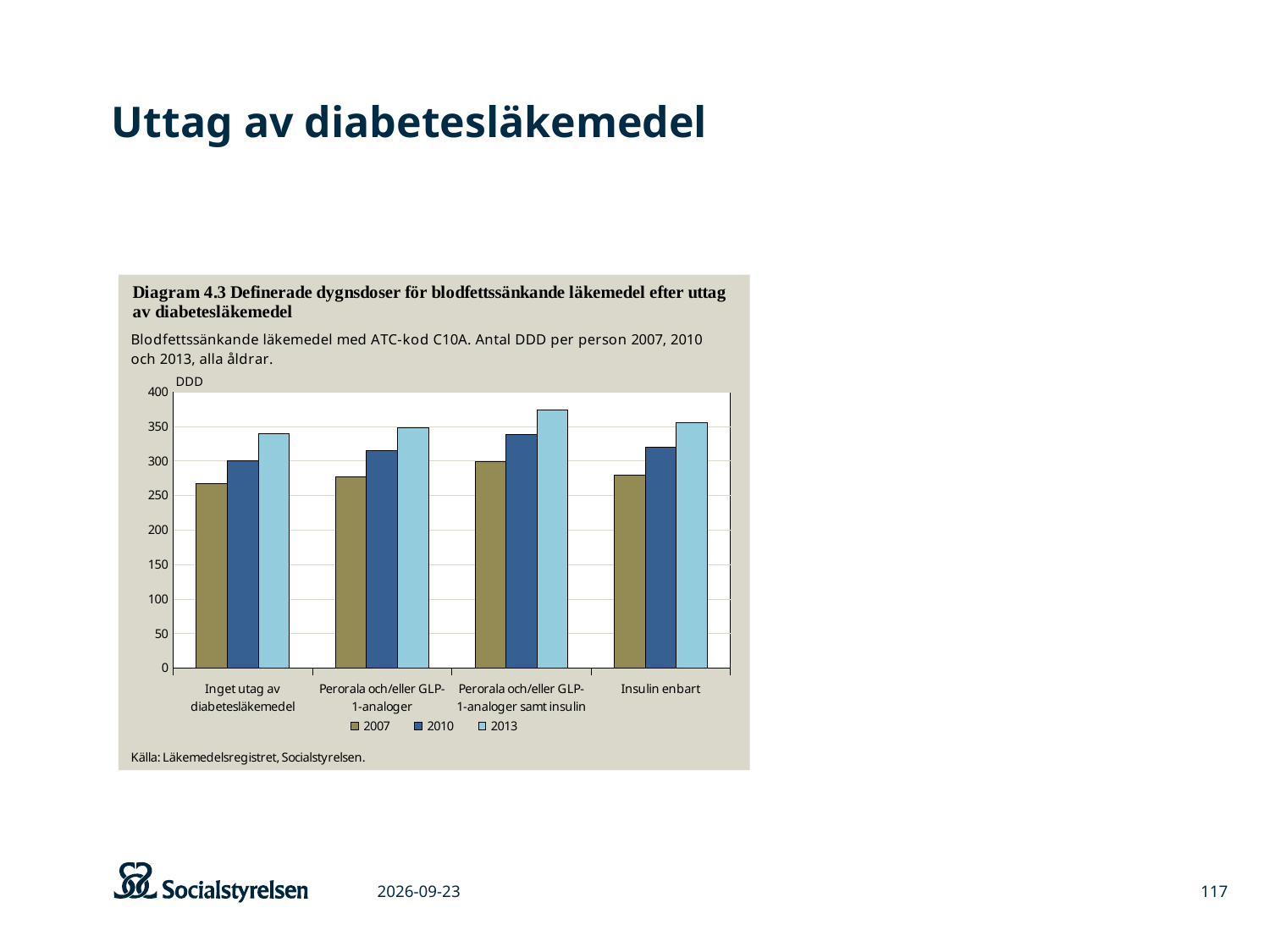
Is the 2013 value for 'Perorala och/eller GLP-1-analoger samt insulin' greater or less than 350? greater How many categories are shown on the x axis of the chart? 4 What unit label is shown at the top of the y axis? DDD Is the 2010 value for 'Insulin enbart' greater or less than 300? greater Which is larger: the 2007 value for 'Perorala och/eller GLP-1-analoger samt insulin' or the 2007 value for 'Inget utag av diabetesläkemedel'? Perorala och/eller GLP-1-analoger samt insulin Within each category, do the values rise or fall from 2007 to 2013? rise What kind of chart is shown on the slide? Bar chart Is the 2007 value for 'Inget utag av diabetesläkemedel' greater or less than 300? less Which category has the highest 2013 value? Perorala och/eller GLP-1-analoger samt insulin How many series does the chart's legend list? 3 Which years are listed in the chart's legend? 2007, 2010, 2013